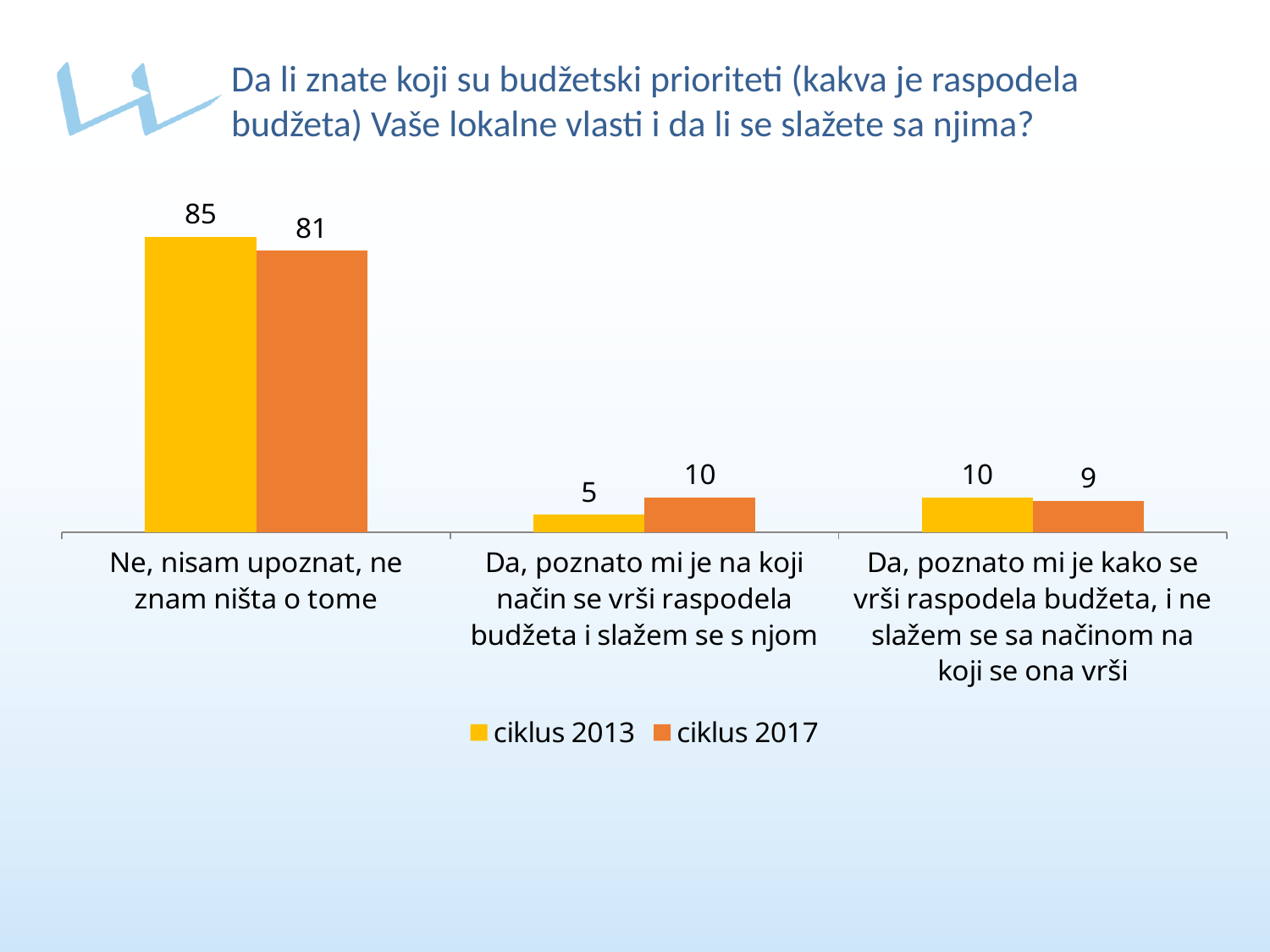
What is the value for "Ne, nisam upoznat, ne znam ništa o tome" in the ciklus 2013 series? 85 For "Da, poznato mi je na koji način se vrši raspodela budžeta i slažem se s njom", which series has the larger value, ciklus 2013 or ciklus 2017? ciklus 2017 Which category has the lowest value in the ciklus 2013 series? Da, poznato mi je na koji način se vrši raspodela budžeta i slažem se s njom What is the ciklus 2017 value for "Da, poznato mi je kako se vrši raspodela budžeta, i ne slažem se sa načinom na koji se ona vrši"? 9 Which category has the highest value in the ciklus 2017 series? Ne, nisam upoznat, ne znam ništa o tome What is the ciklus 2013 value for "Da, poznato mi je na koji način se vrši raspodela budžeta i slažem se s njom"? 5 Which colour represents the ciklus 2013 series? yellow What is the difference between the ciklus 2013 and ciklus 2017 values for "Ne, nisam upoznat, ne znam ništa o tome"? 4 What kind of chart is shown on the slide? bar chart What is the value for "Ne, nisam upoznat, ne znam ništa o tome" in the ciklus 2017 series? 81 How many series does the legend list? 2 How many categories are shown on the x axis? 3